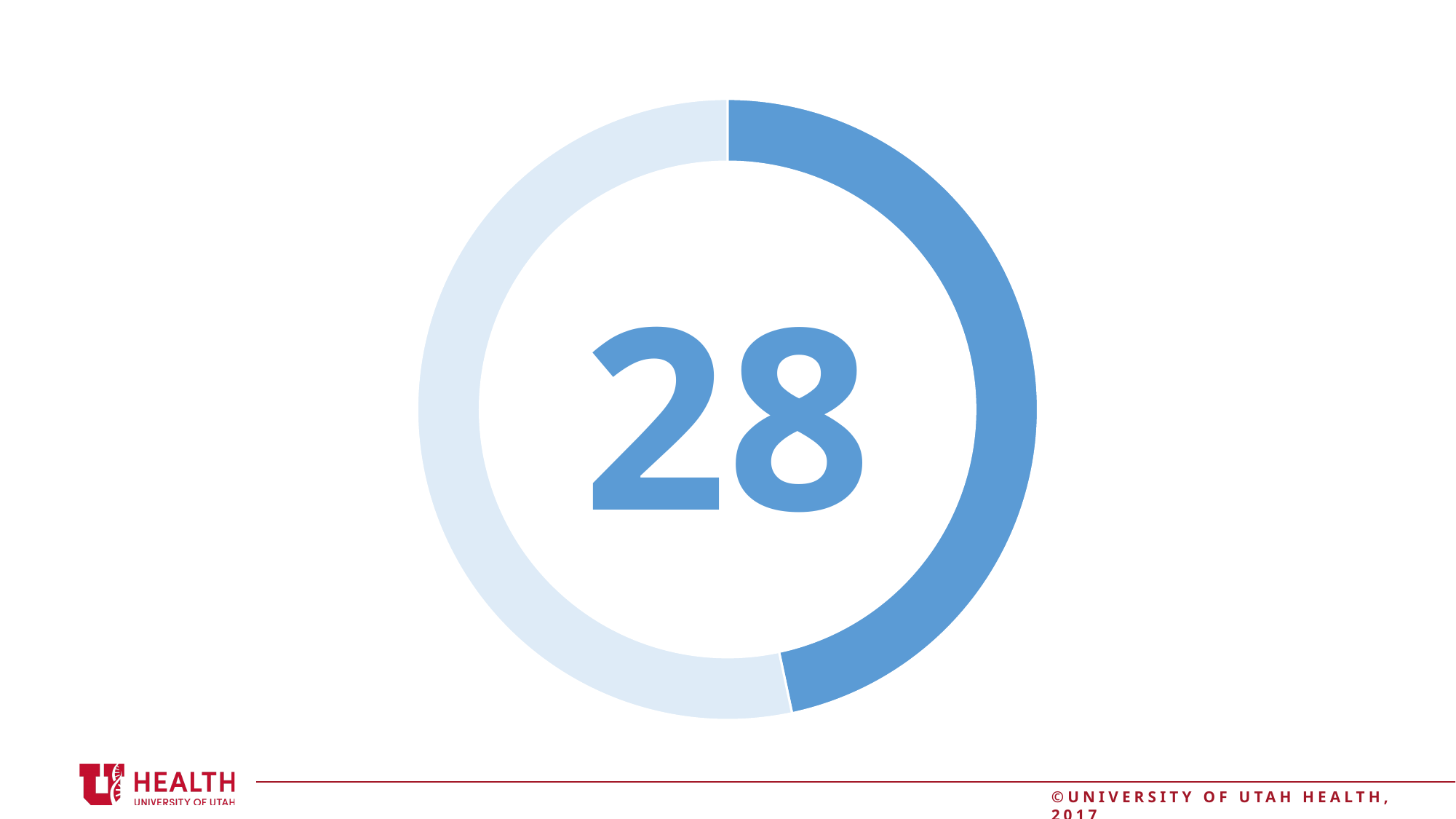
What number is displayed in the centre of the donut chart? 28 What kind of chart is shown on the slide? Donut chart How many segments does the donut chart have? 2 What colour is the filled (highlighted) segment of the donut chart? Blue Does the donut chart have a legend? No